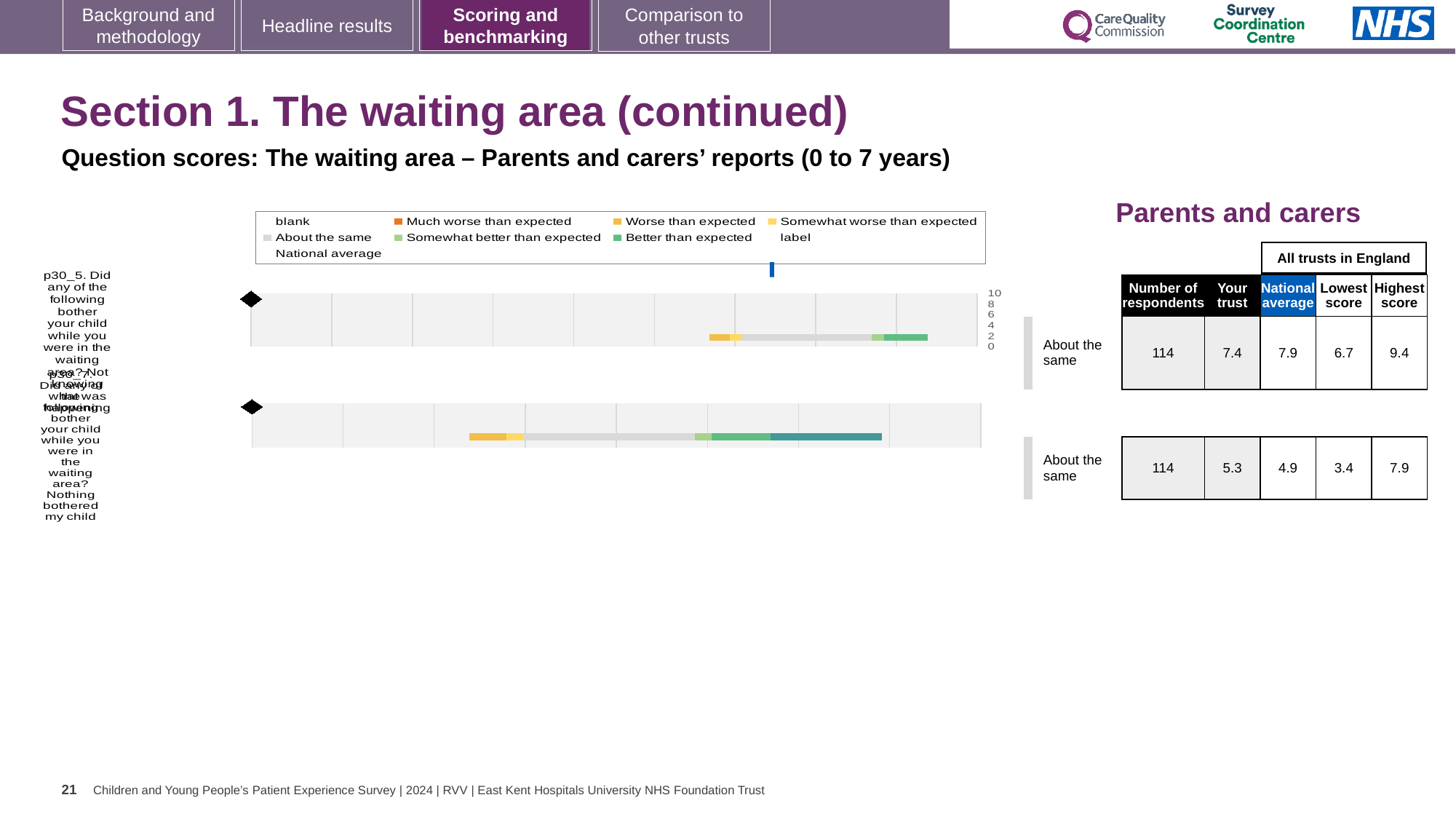
Which legend entry is shown in light grey? About the same In the table next to the charts, what is the Highest score for the second question (p30_7)? 7.9 In the table next to the charts, what is the 'Your trust' score for the first question (p30_5)? 7.4 In the table next to the charts, what is the National average for the first question (p30_5)? 7.9 Which legend entry is shown in orange? Much worse than expected How many respondents are listed for each question in the table next to the charts? 114 What benchmark category is given for both questions beside the charts? About the same What kind of chart is used to show the question scores on this slide? bar chart Which is larger for the second question (p30_7): the 'Your trust' score or the National average? Your trust In the table next to the charts, what is the Lowest score for the first question (p30_5)? 6.7 In the table next to the charts, what is the 'Your trust' score for the second question (p30_7)? 5.3 How many bar charts are shown on the slide? 2